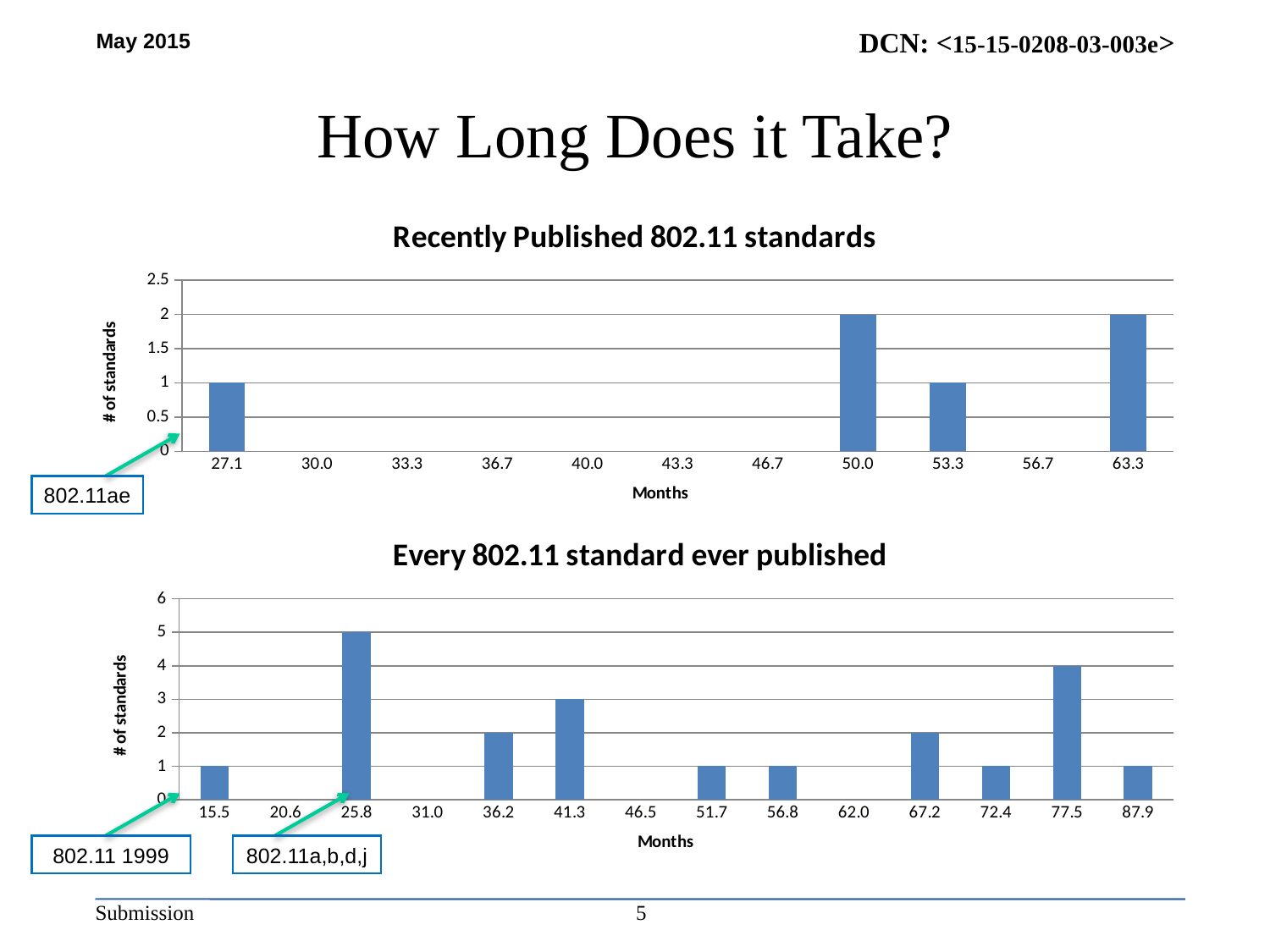
What is the y-axis label of the 'Every 802.11 standard ever published' chart? # of standards How many months categories are shown on the x axis of the 'Every 802.11 standard ever published' chart? 14 In the 'Recently Published 802.11 standards' chart, what is the number of standards at 27.1 months? 1 In the 'Every 802.11 standard ever published' chart, which months category has the highest number of standards? 25.8 In the 'Every 802.11 standard ever published' chart, what is the difference between the number of standards at 25.8 months and at 41.3 months? 2 In the 'Recently Published 802.11 standards' chart, what is the number of standards at 50.0 months? 2 In the 'Every 802.11 standard ever published' chart, which has more standards: 36.2 months or 41.3 months? 41.3 What type of chart is the 'Recently Published 802.11 standards' chart? bar chart In the 'Every 802.11 standard ever published' chart, what is the number of standards at 25.8 months? 5 How many months categories are shown on the x axis of the 'Recently Published 802.11 standards' chart? 11 In the 'Every 802.11 standard ever published' chart, what is the number of standards at 77.5 months? 4 In the 'Recently Published 802.11 standards' chart, which has more standards: 53.3 months or 63.3 months? 63.3